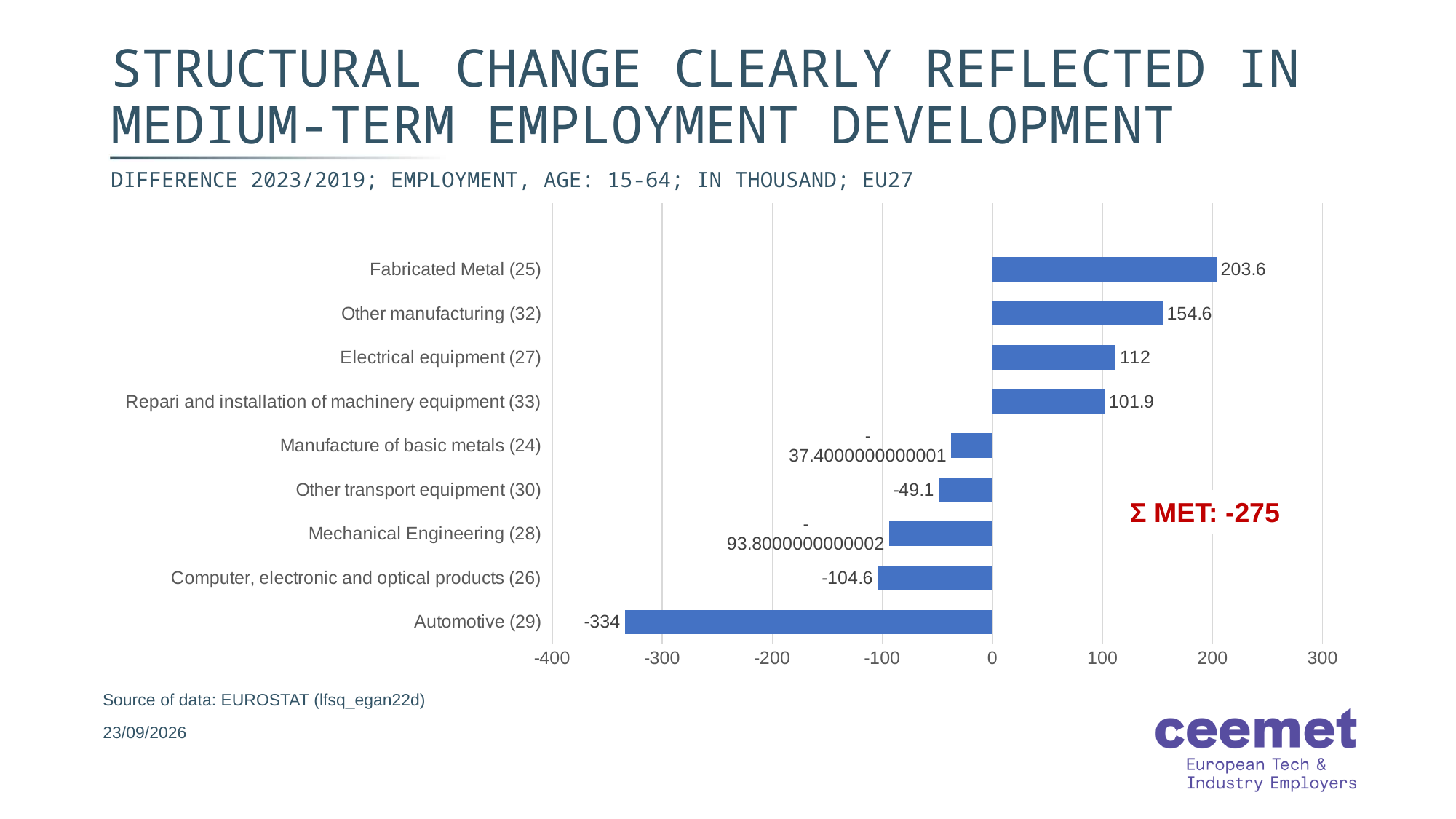
Is the value for Computer, electronic and optical products (26) greater or less than -100? less Which sector has the highest value in the chart? Fabricated Metal (25) What kind of chart is shown on the slide? bar chart What is the difference between the values for Fabricated Metal (25) and Other manufacturing (32)? 49 Which sector has the lowest value in the chart? Automotive (29) What is the value for Automotive (29)? -334 Which has the larger value, Other manufacturing (32) or Electrical equipment (27)? Other manufacturing (32) What is the value for Fabricated Metal (25)? 203.6 What is the value for Other transport equipment (30)? -49.1 What is the value for Electrical equipment (27)? 112 What total for MET is annotated in red on the chart? Σ MET: -275 How many sectors are plotted in the chart? 9